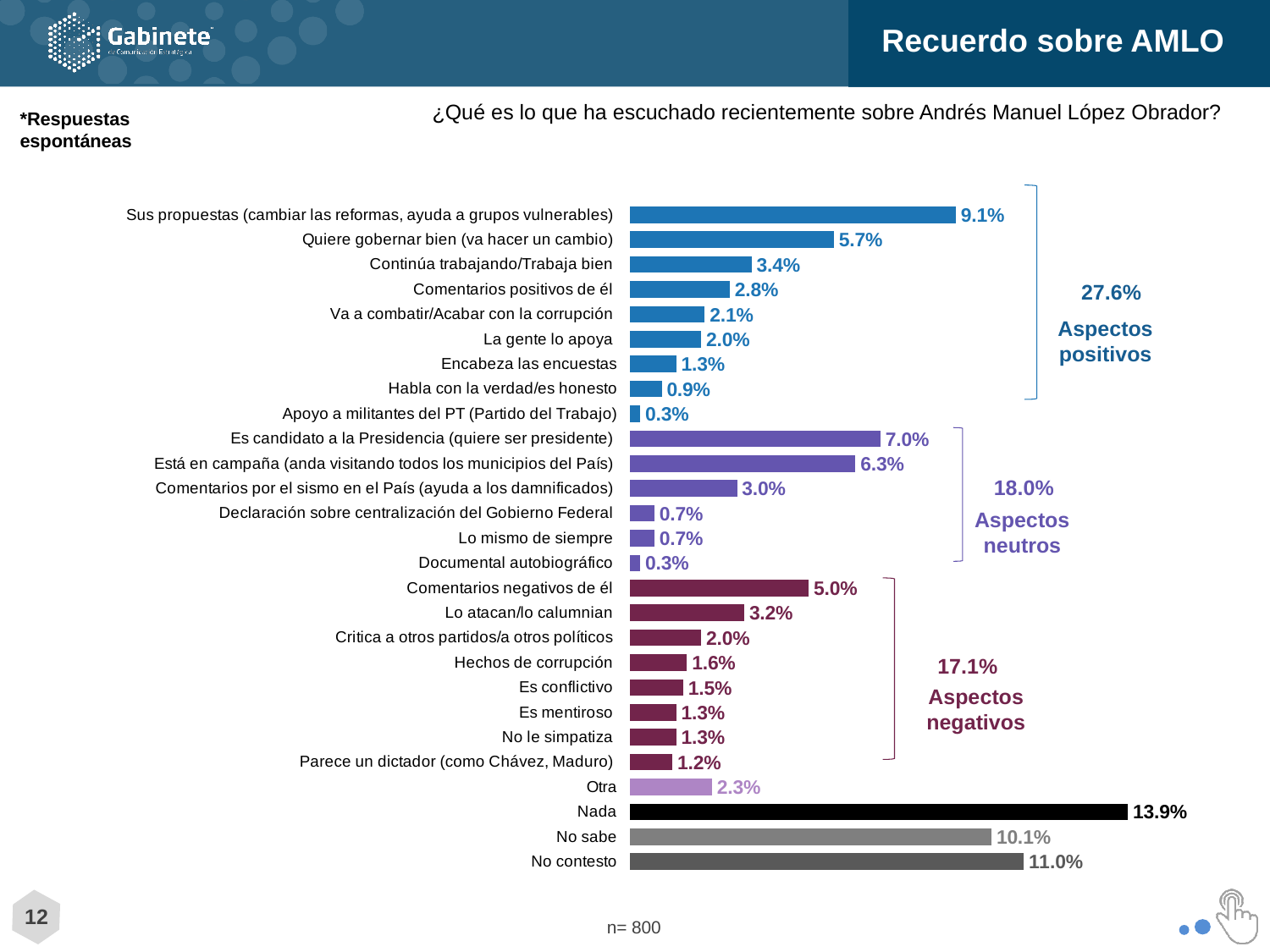
What total percentage is shown for the "Aspectos negativos" group? 17.1% What is the difference between "Sus propuestas (cambiar las reformas, ayuda a grupos vulnerables)" and "Quiere gobernar bien (va hacer un cambio)"? 3.4% What is the value for "Es candidato a la Presidencia (quiere ser presidente)"? 7.0% What percentage is shown for "Sus propuestas (cambiar las reformas, ayuda a grupos vulnerables)"? 9.1% What total percentage is shown for the "Aspectos positivos" group? 27.6% How many categories are plotted in the chart? 27 What is the difference between the values for "Nada" and "No sabe"? 3.8% What percentage is shown for "Comentarios negativos de él"? 5.0% Which category has the highest value in the chart? Nada Which is larger, the value for "Está en campaña (anda visitando todos los municipios del País)" or for "Quiere gobernar bien (va hacer un cambio)"? Está en campaña (anda visitando todos los municipios del País) What type of chart is shown on the slide? bar chart What is the value for "No contesto"? 11.0%